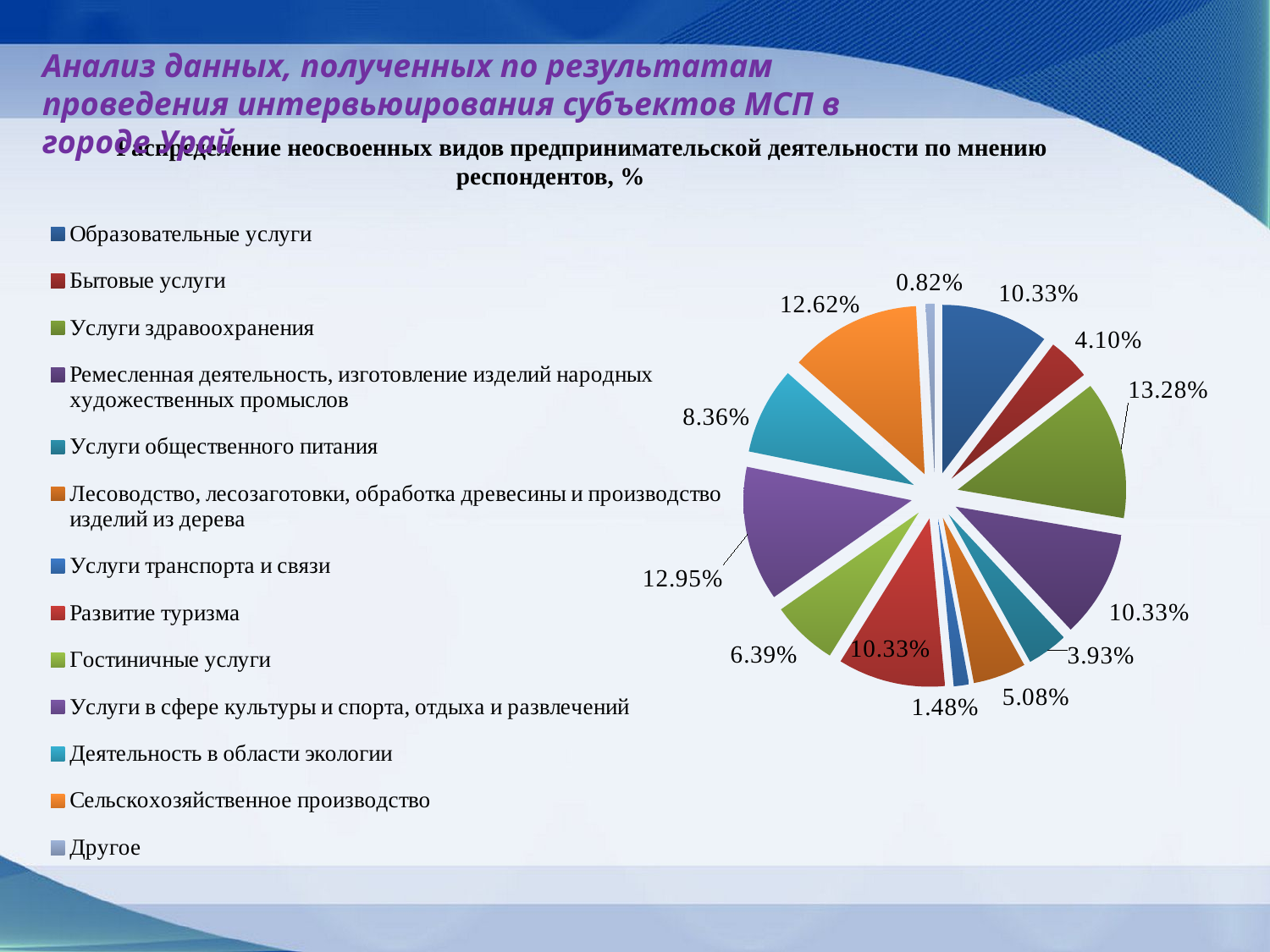
What value is shown for Деятельность в области экологии? 8.36% What is the title of the chart? Распределение неосвоенных видов предпринимательской деятельности по мнению респондентов, % What value is shown for Услуги транспорта и связи? 1.48% How many categories does the legend of the pie chart list? 13 Which is larger: the share for Бытовые услуги or the share for Лесоводство, лесозаготовки, обработка древесины и производство изделий из дерева? Лесоводство, лесозаготовки, обработка древесины и производство изделий из дерева What is the difference between the shares for Услуги в сфере культуры и спорта, отдыха и развлечений and Гостиничные услуги? 6.56% What share of the pie is labelled for Услуги здравоохранения? 13.28% What value is shown for Сельскохозяйственное производство? 12.62% What type of chart is shown on the slide? Pie chart What is the difference between the shares for Услуги здравоохранения and Другое? 12.46% Which category has the smallest share of the pie? Другое Which category has the largest share of the pie? Услуги здравоохранения